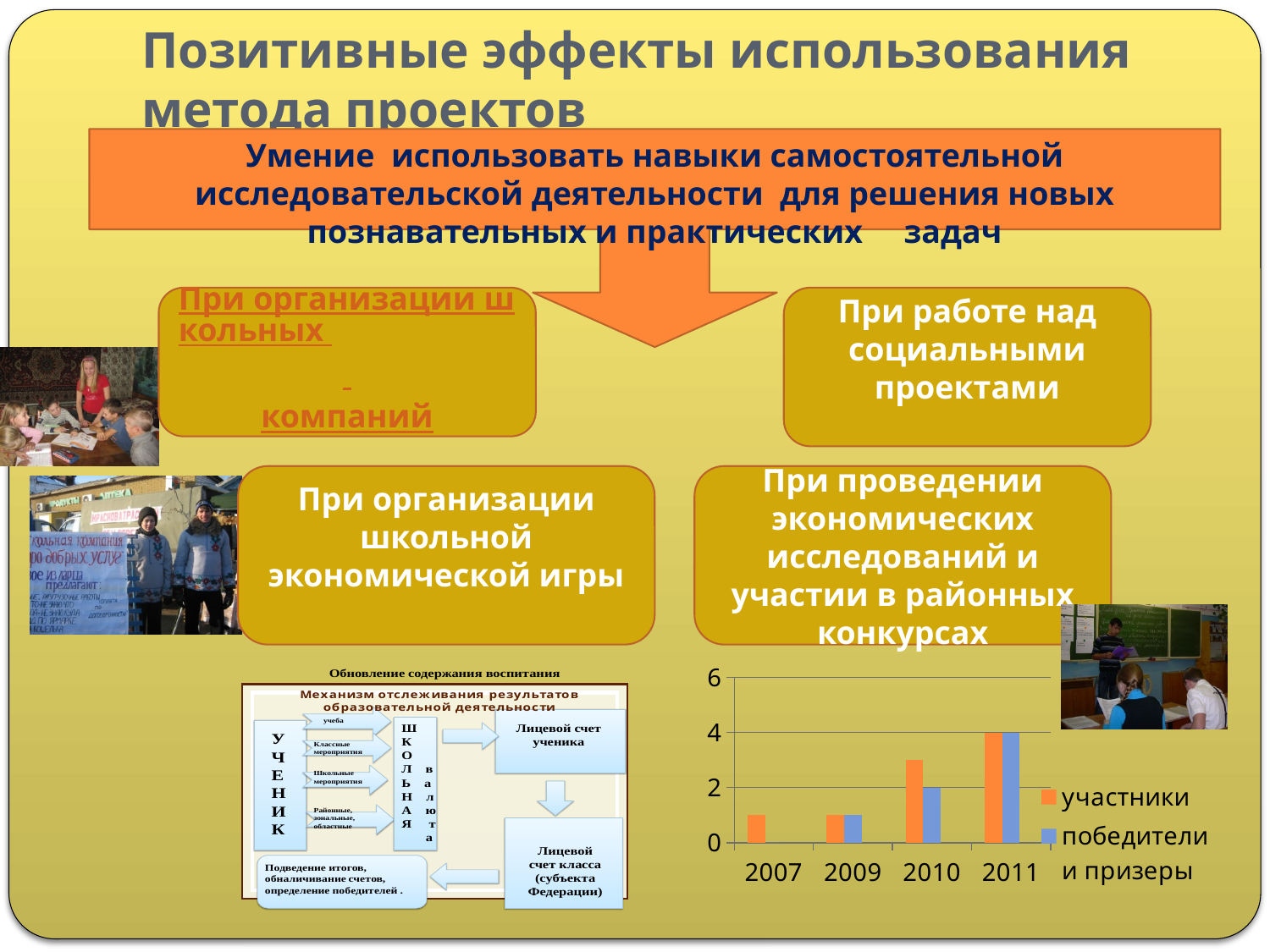
How many series does the legend of the bar chart list? 2 Which colour represents участники in the bar chart? orange Is the value for участники in 2010 greater or less than 2? greater How many years are shown on the x axis of the bar chart? 4 In which year is the value for участники highest on the bar chart? 2011 Is the value for участники in 2007 greater or less than 2? less What kind of chart is shown at the bottom right of the slide? bar chart What is the value for победители и призеры in 2011 on the bar chart? 4 What is the value for участники in 2011 on the bar chart? 4 Which is larger in 2010: участники or победители и призеры? участники Do the values for участники rise or fall from 2009 to 2011 on the bar chart? rise What is the value for победители и призеры in 2010 on the bar chart? 2